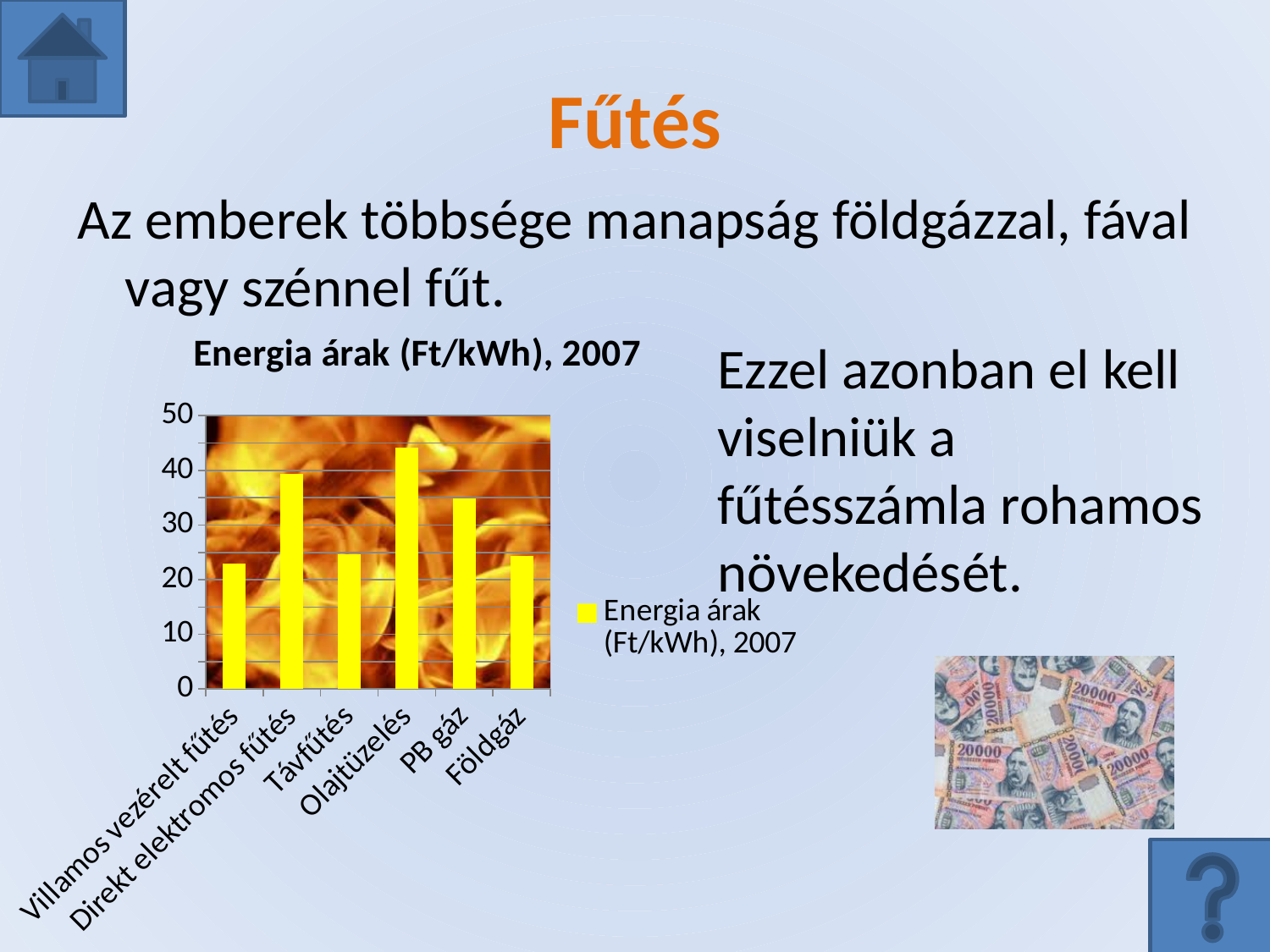
Is the value for Villamos vezérelt fűtés greater or less than 30? less Is the value for Földgáz greater or less than 20? greater Is the value for PB gáz greater or less than 40? less Which category has the highest value in the chart? Olajtüzelés What kind of chart is shown on the slide? bar chart Which is larger, the value for Olajtüzelés or the value for Távfűtés? Olajtüzelés What is the title of the chart? Energia árak (Ft/kWh), 2007 Which is larger, the value for Direkt elektromos fűtés or the value for PB gáz? Direkt elektromos fűtés How many categories are shown on the x axis of the chart? 6 How many series does the chart legend list? 1